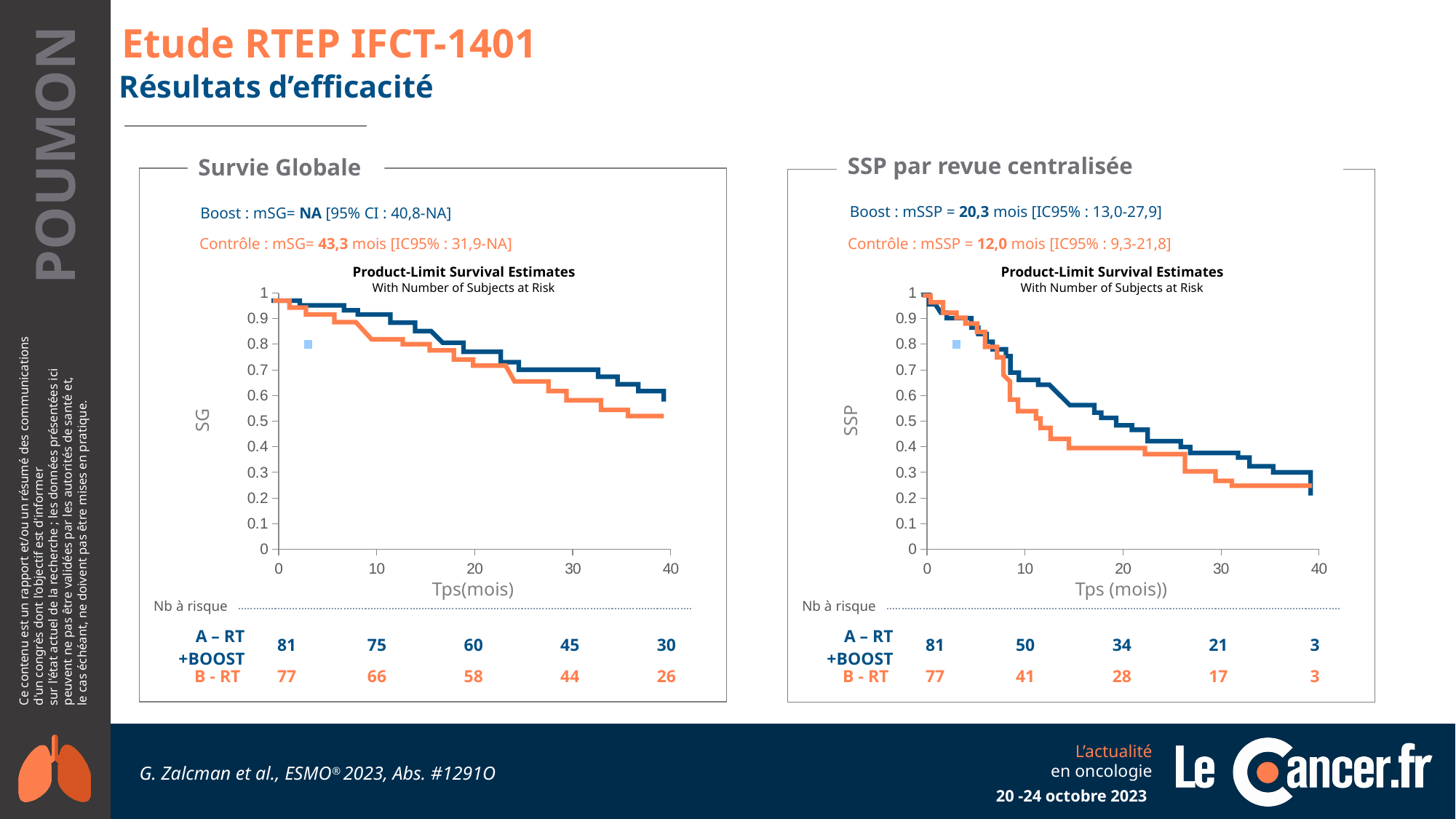
In the 'Survie Globale' chart, is the Boost (blue) curve at 30 months greater or less than 0.6? greater In the 'SSP par revue centralisée' chart, how many subjects are at risk in the B - RT arm at 10 months? 41 In the 'Survie Globale' chart, what is the median overall survival (mSG) reported for the Contrôle arm? 43,3 mois What kind of chart is the 'Survie Globale' chart? line chart In the 'SSP par revue centralisée' chart, do the survival curves rise or fall as time increases? fall In the 'SSP par revue centralisée' chart, what is the median PFS (mSSP) reported for the Boost arm? 20,3 mois In the 'Survie Globale' chart, how many subjects are at risk in the A – RT +BOOST arm at 20 months? 60 In the 'Survie Globale' chart, what is the difference between the number at risk for A – RT +BOOST and B - RT at 0 months? 4 In the 'SSP par revue centralisée' chart, is the Contrôle (orange) curve at 20 months greater or less than 0.5? less In the 'Survie Globale' chart, how many time points are listed in the number-at-risk table? 5 In the 'SSP par revue centralisée' chart, which arm has more subjects at risk at 10 months, A – RT +BOOST or B - RT? A – RT +BOOST What is the x-axis label of the 'Survie Globale' chart? Tps(mois)